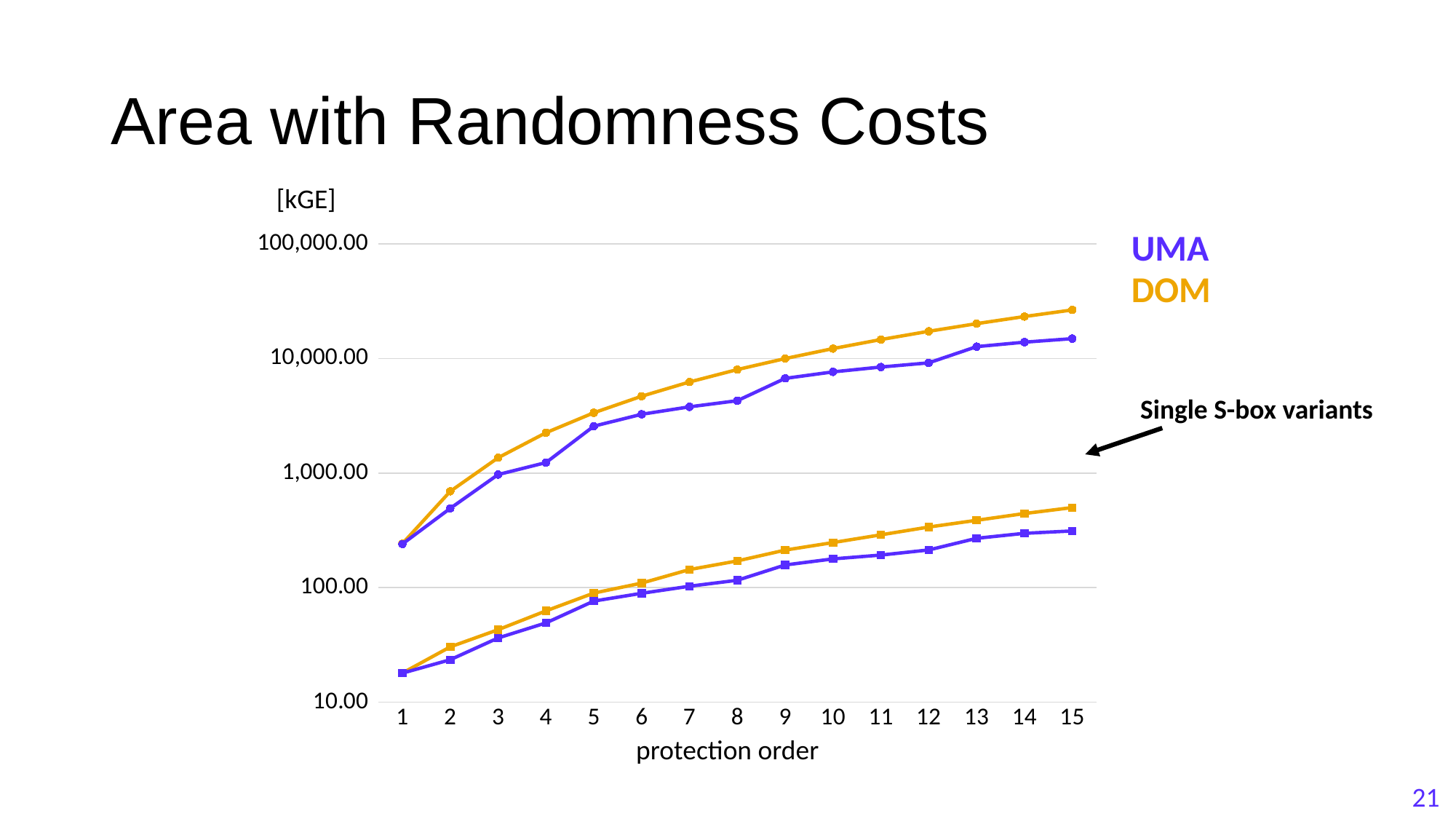
What is the title of the slide? Area with Randomness Costs What unit is shown for the y axis? [kGE] How many protection orders are plotted along the x axis? 15 How many lines are plotted on the chart in total? 4 Is the value of the upper DOM line at protection order 3 greater or less than 1,000.00? greater Is the value of the lower (single S-box) UMA line at protection order 5 greater or less than 100.00? less Is the value of the upper UMA line at protection order 15 greater or less than 10,000.00? greater What kind of chart is shown on the slide? line chart At protection order 15, which of the two upper lines is higher, UMA or DOM? DOM Do the values rise or fall as the protection order increases? rise How many series does the legend list? 2